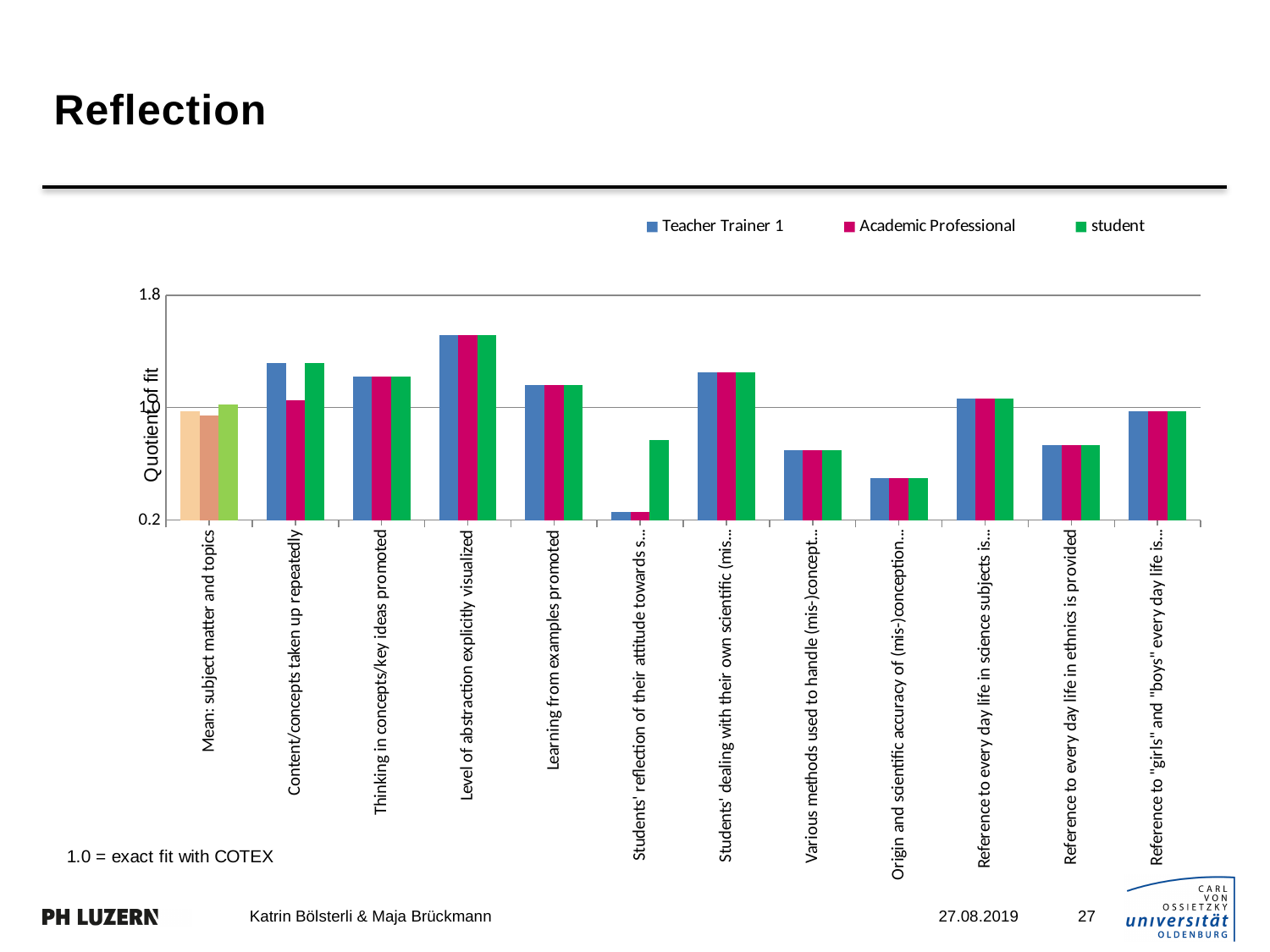
Is the Teacher Trainer 1 value for 'Content/concepts taken up repeatedly' greater or less than 1.0? greater Is the Teacher Trainer 1 value for 'Level of abstraction explicitly visualized' greater or less than 1.0? greater Which category has the higher Teacher Trainer 1 value: 'Level of abstraction explicitly visualized' or 'Learning from examples promoted'? Level of abstraction explicitly visualized For 'Students' reflection of their attitude towards s...', which series has the larger value: student or Teacher Trainer 1? student Which category has the lowest Teacher Trainer 1 value? Students' reflection of their attitude towards s... Which category has the highest values across all three series? Level of abstraction explicitly visualized What is the title of the y axis? Quotient of fit Is the Academic Professional value for 'Various methods used to handle (mis-)concept...' greater or less than 1.0? less What kind of chart is shown on the slide? bar chart How many series does the legend list? 3 How many categories are shown along the x axis? 12